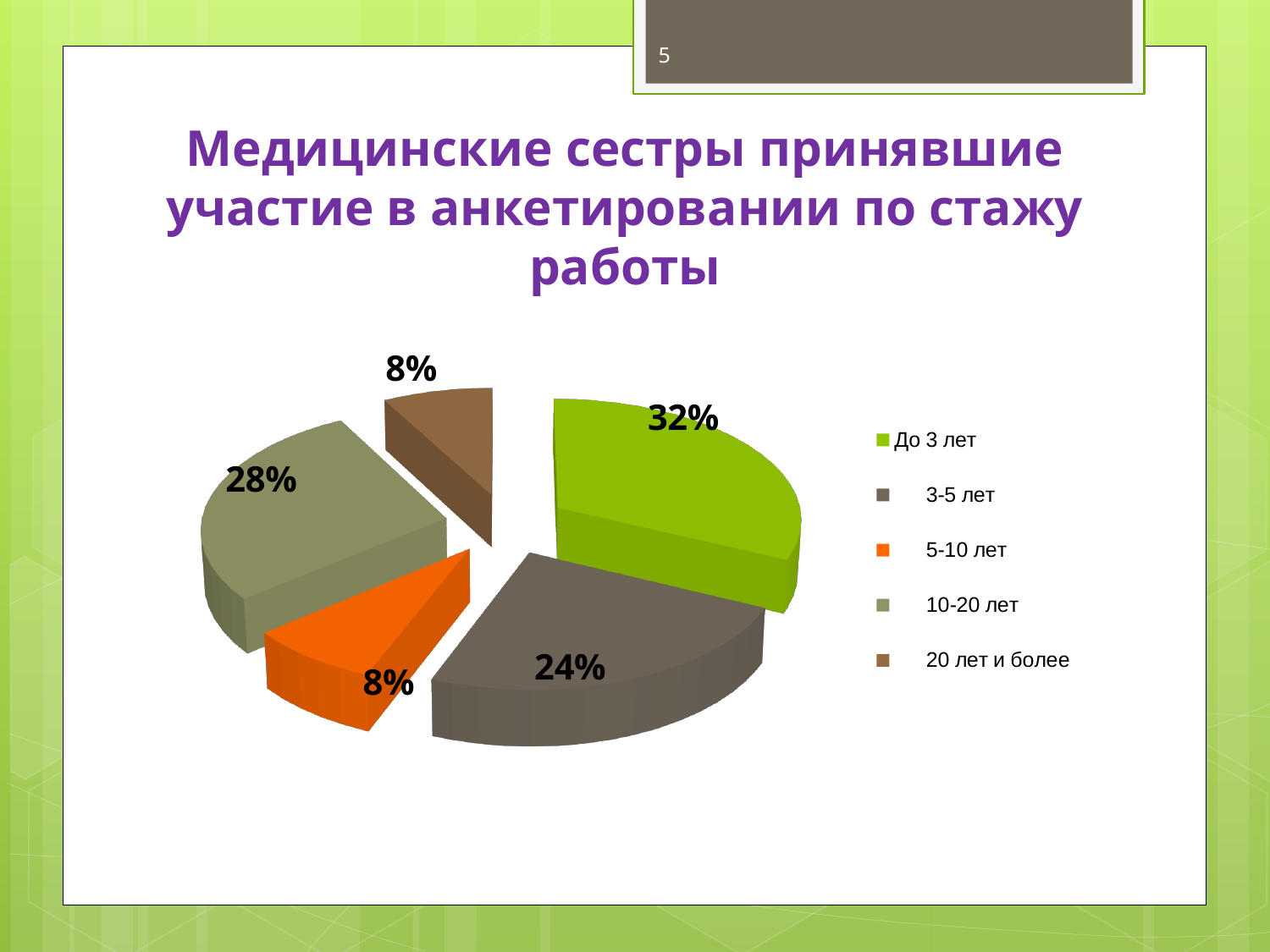
What colour is the 'До 3 лет' slice? Green What share of the pie does the '5-10 лет' slice represent? 8% Which slice is larger, '10-20 лет' or '3-5 лет'? 10-20 лет What share of the pie does the 'До 3 лет' slice represent? 32% What share of the pie does the '20 лет и более' slice represent? 8% What share of the pie does the '10-20 лет' slice represent? 28% What is the difference in percentage points between the 'До 3 лет' and '3-5 лет' slices? 8 How many categories does the pie chart have? 5 What type of chart is shown on the slide? Pie chart What share of the pie does the '3-5 лет' slice represent? 24% What is the difference in percentage points between the '10-20 лет' and '5-10 лет' slices? 20 Which category has the largest share of the pie? До 3 лет